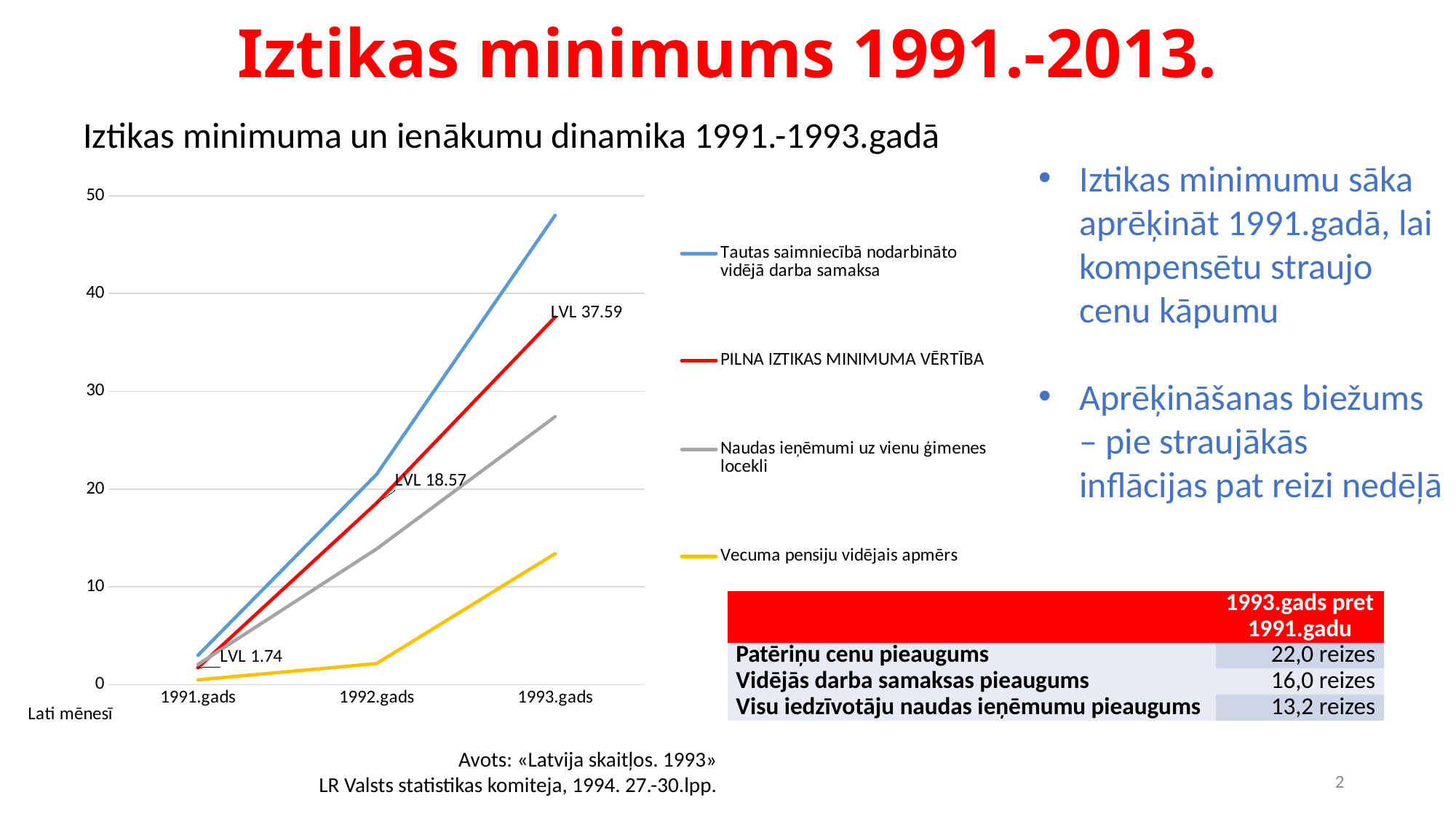
What is the value of PILNA IZTIKAS MINIMUMA VĒRTĪBA in 1991.gads? LVL 1.74 What type of chart is shown on the slide? line chart Do the values of PILNA IZTIKAS MINIMUMA VĒRTĪBA rise or fall from 1991.gads to 1993.gads? rise By how much did PILNA IZTIKAS MINIMUMA VĒRTĪBA increase from 1992.gads to 1993.gads? LVL 19.02 What is the value of PILNA IZTIKAS MINIMUMA VĒRTĪBA in 1993.gads? LVL 37.59 What is the title of the chart? Iztikas minimuma un ienākumu dinamika 1991.-1993.gadā How many series does the chart legend list? 4 Is the value for Tautas saimniecībā nodarbināto vidējā darba samaksa in 1993.gads greater or less than 40? greater Which series has the lowest value in 1993.gads? Vecuma pensiju vidējais apmērs What is the value of PILNA IZTIKAS MINIMUMA VĒRTĪBA in 1992.gads? LVL 18.57 Which series has the highest value in 1993.gads? Tautas saimniecībā nodarbināto vidējā darba samaksa How many years are plotted along the x axis of the chart? 3